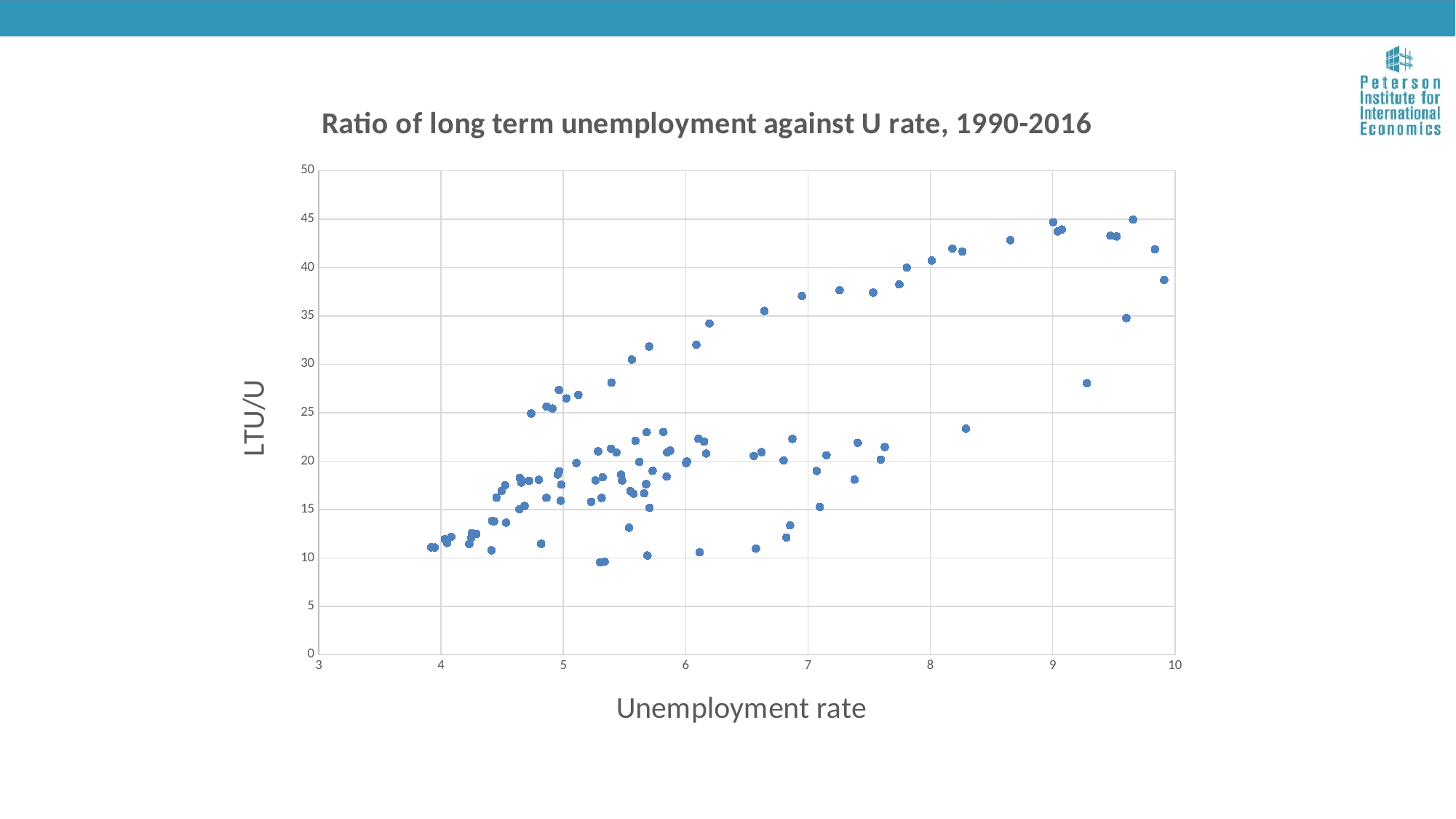
Overall, do the LTU/U values tend to rise or fall as the unemployment rate increases? Rise Is the LTU/U value for the point at an unemployment rate of about 9.3 greater or less than 30? less Is the highest LTU/U value plotted on the chart greater or less than 40? greater Is the lowest LTU/U value plotted on the chart greater or less than 15? less What are the labels of the x axis and the y axis of the chart? Unemployment rate (x axis) and LTU/U (y axis) What kind of chart is shown on the slide? Scatter plot What is the title of the chart? Ratio of long term unemployment against U rate, 1990-2016